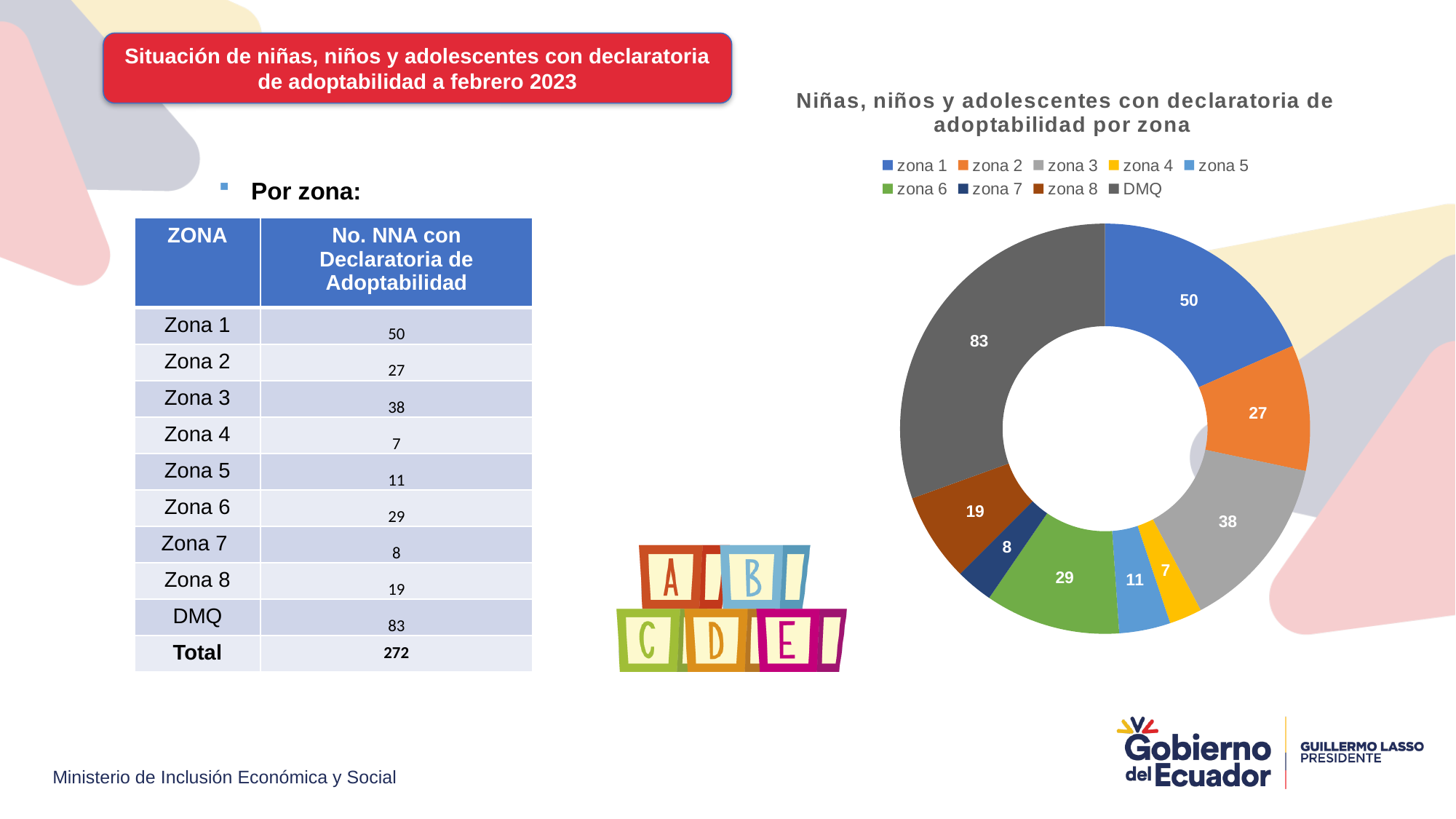
Which category has the largest value in the doughnut chart? DMQ What value is shown for zona 4 in the doughnut chart? 7 Which is larger in the doughnut chart, zona 5 or zona 7? zona 5 How many categories does the doughnut chart show? 9 Which category has the smallest value in the doughnut chart? zona 4 What is the title of the chart on the slide? Niñas, niños y adolescentes con declaratoria de adoptabilidad por zona What is the difference between the values for DMQ and zona 1 in the doughnut chart? 33 What value is shown for DMQ in the doughnut chart? 83 What is the difference between the values for zona 3 and zona 2 in the doughnut chart? 11 What value is shown for zona 6 in the doughnut chart? 29 What value is shown for zona 1 in the doughnut chart? 50 What kind of chart is shown on the slide? doughnut chart